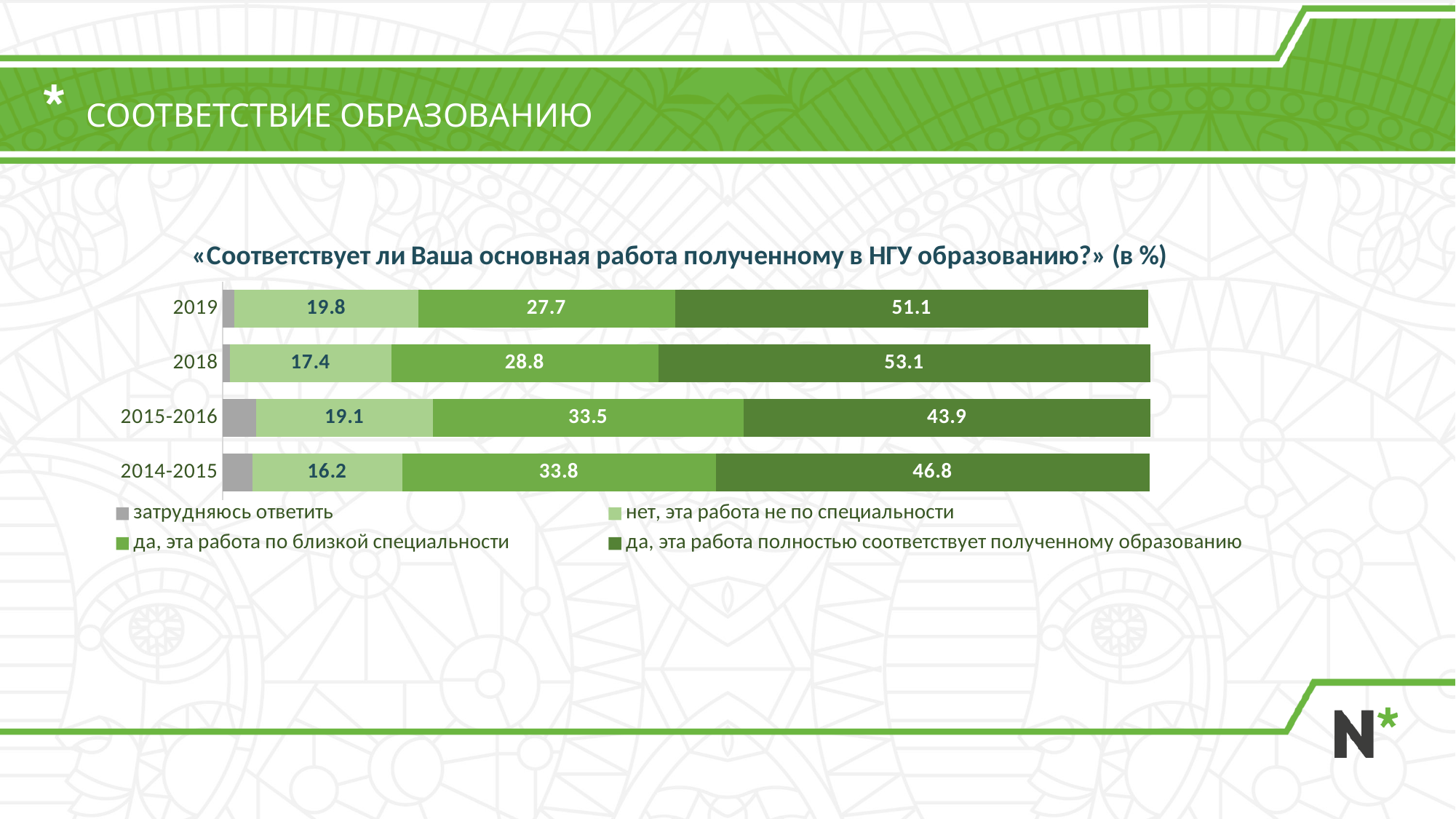
In which year group is the value for «да, эта работа полностью соответствует полученному образованию» highest? 2018 How many series does the legend list? 4 How many categories (year groups) are shown on the chart? 4 Does the value for «да, эта работа по близкой специальности» fall or rise from 2014-2015 to 2019? fall What is the value for «нет, эта работа не по специальности» in 2014-2015? 16.2 What is the value for «да, эта работа по близкой специальности» in 2015-2016? 33.5 Which is larger: the «да, эта работа по близкой специальности» value for 2019 or for 2014-2015? 2014-2015 What is the value for «да, эта работа полностью соответствует полученному образованию» in 2019? 51.1 What type of chart is shown on the slide? stacked bar chart What is the title of the chart? «Соответствует ли Ваша основная работа полученному в НГУ образованию?» (в %) In which year group is the value for «да, эта работа полностью соответствует полученному образованию» lowest? 2015-2016 What is the difference between the «да, эта работа полностью соответствует полученному образованию» values for 2018 and 2015-2016? 9.2